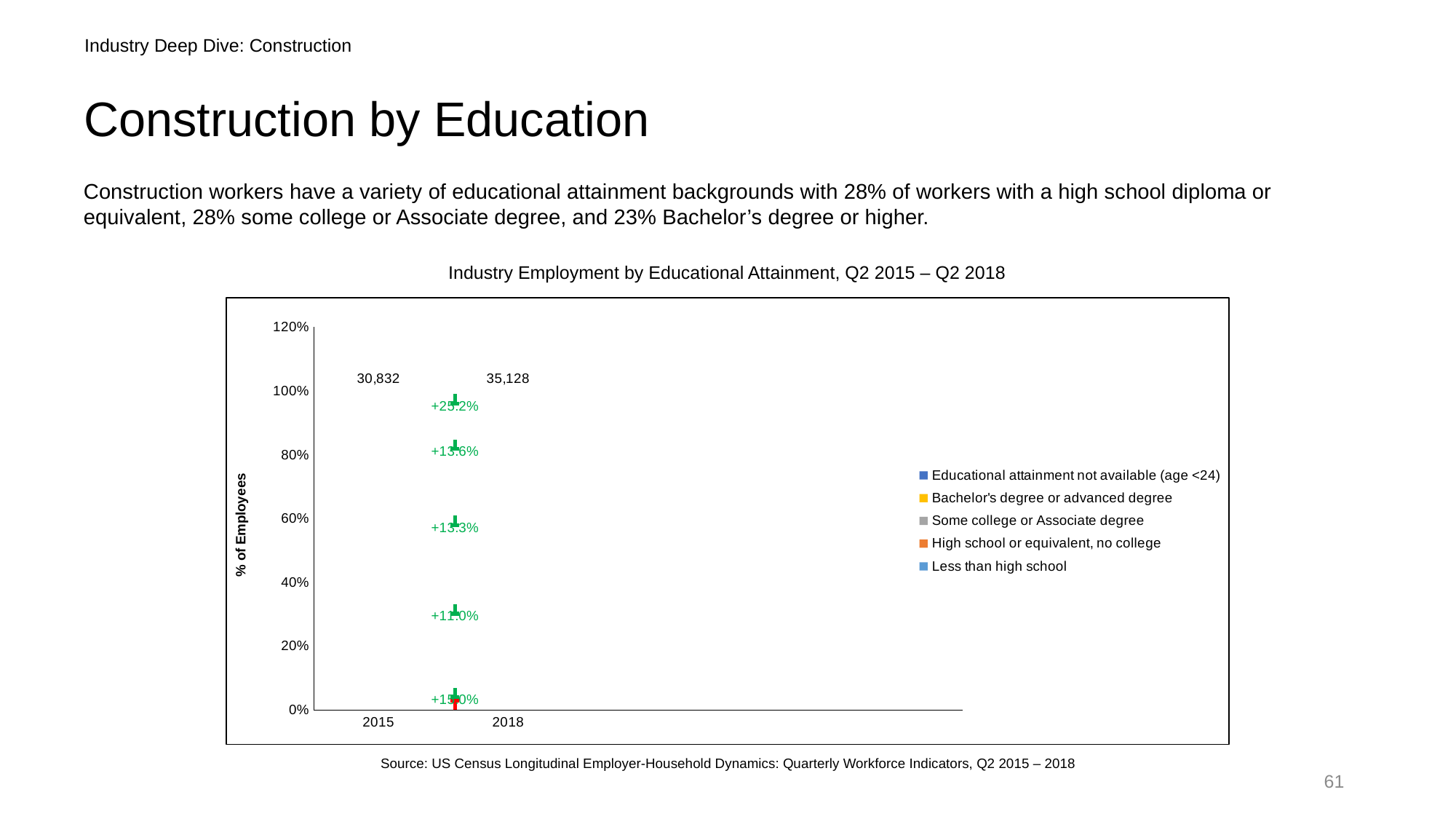
What total employment figure is printed above the 2015 bar? 30,832 What total employment figure is printed above the 2018 bar? 35,128 What is the largest percentage change label shown between the 2015 and 2018 bars? +25.2% Which year has the larger total employment figure, 2015 or 2018? 2018 Which legend entry is listed first (at the top) in the chart legend? Educational attainment not available (age <24) What is the highest value shown on the y axis of the chart? 120% What is the smallest percentage change label shown between the 2015 and 2018 bars? +11.0% How many series does the chart legend list? 5 What is the title of the chart? Industry Employment by Educational Attainment, Q2 2015 – Q2 2018 What is the difference between the 2018 total (35,128) and the 2015 total (30,832)? 4,296 How many years are shown on the x axis of the chart? 2 What is the label of the y axis? % of Employees